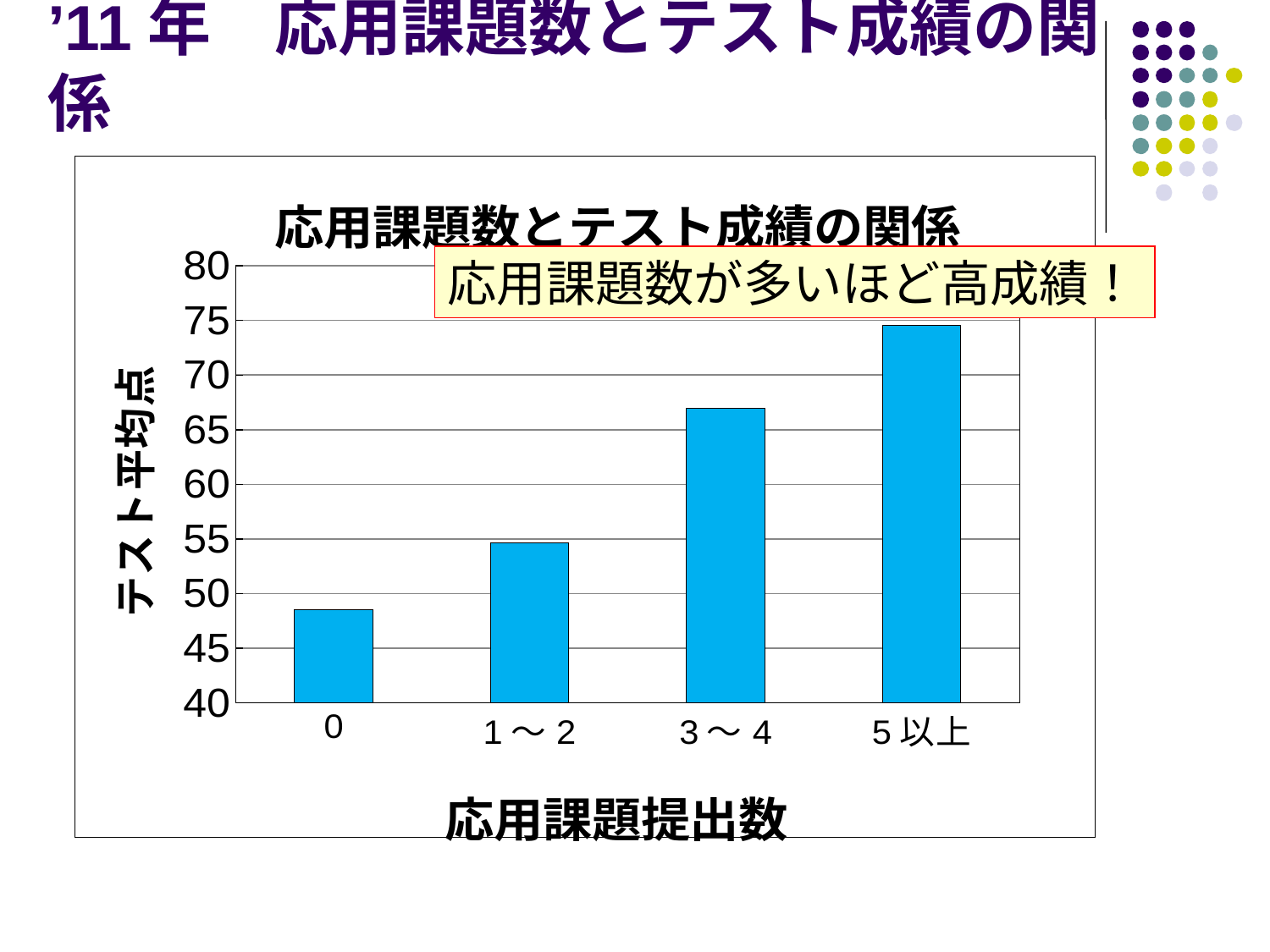
Is the value for the category 5以上 greater or less than 70? greater Is the value for the category 0 greater or less than 50? less Do the values rise or fall as the number of submitted applied assignments increases along the x axis? rise Is the value for the category 3～4 greater or less than 65? greater Which has a higher average test score, the category 1～2 or the category 3～4? 3～4 What is the label of the x axis of the chart? 応用課題提出数 How many categories are shown on the x axis of the chart? 4 Which category has the lowest average test score (テスト平均点)? 0 What is the title of the chart? 応用課題数とテスト成績の関係 What kind of chart is shown on the slide? bar chart Which category has the highest average test score (テスト平均点)? 5以上